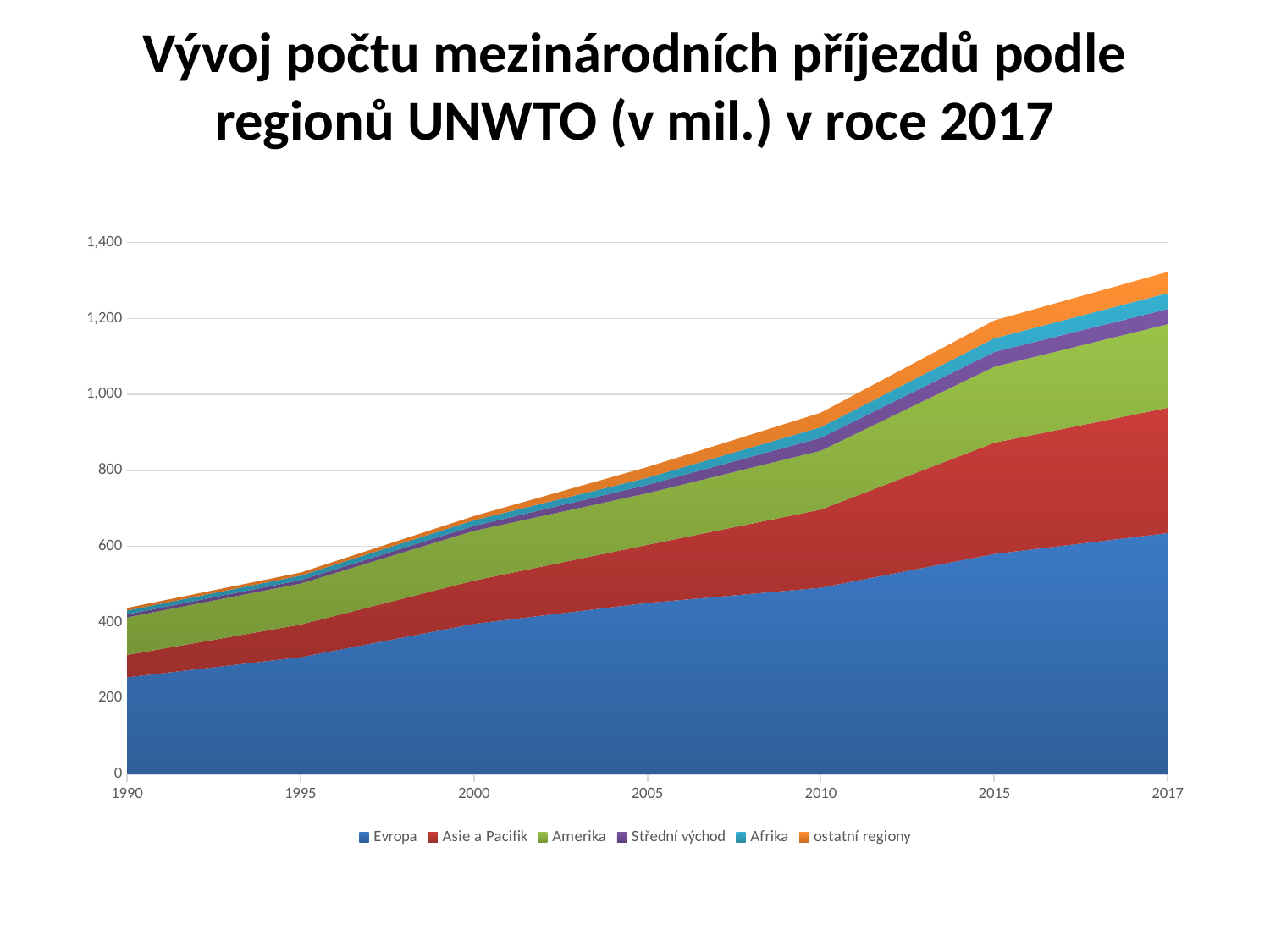
Which region has the largest band in the chart? Evropa Is the value for Evropa in 1990 greater or less than 200? greater In 2017, which is larger: the value for Evropa or the value for Asie a Pacifik? Evropa How many series does the legend list? 6 Is the stacked total for 2017 greater or less than 1,200? greater Is the value for Evropa in 2017 greater or less than 600? greater How many years are marked on the x axis? 7 What is the title of the chart? Vývoj počtu mezinárodních příjezdů podle regionů UNWTO (v mil.) v roce 2017 What is the first series listed in the legend? Evropa What kind of chart is shown on the slide? stacked area chart Does the total number of international arrivals rise or fall from 1990 to 2017? rise